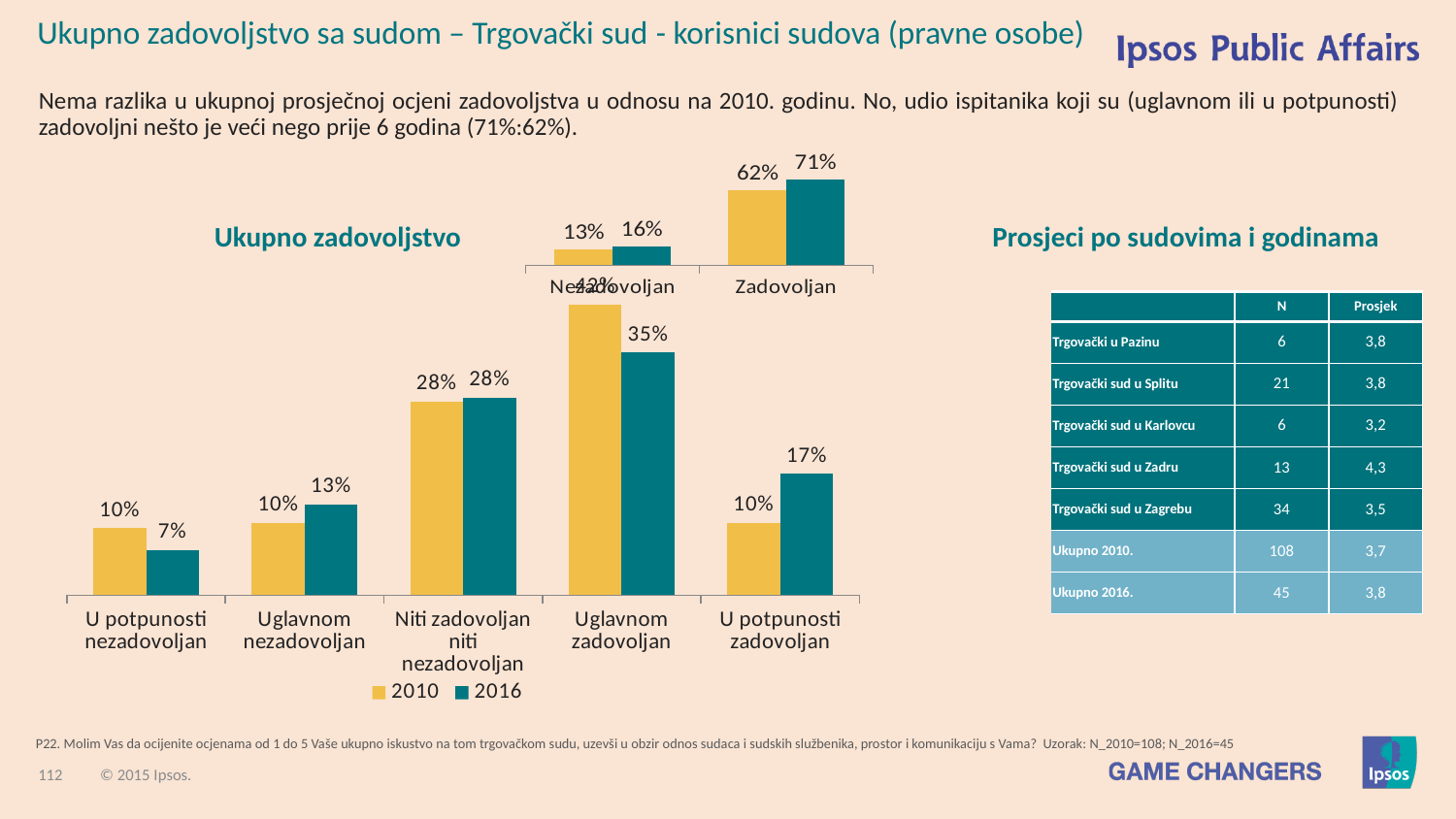
In the 'Ukupno zadovoljstvo' chart, what is the difference between the 2016 and 2010 values for 'U potpunosti zadovoljan'? 7% In the 'Ukupno zadovoljstvo' chart, which category has the lowest 2016 value? U potpunosti nezadovoljan How many series does the legend of the 'Ukupno zadovoljstvo' chart list? 2 In the 'Ukupno zadovoljstvo' chart, what is the 2016 value for 'U potpunosti nezadovoljan'? 7% In the small inset chart at the top, what is the difference between the 2016 and 2010 values for 'Zadovoljan'? 9% In the 'Ukupno zadovoljstvo' chart, is the 2016 value for 'Uglavnom nezadovoljan' larger or smaller than the 2010 value? larger In the small inset chart at the top, what is the 2016 value for 'Zadovoljan'? 71% How many categories are shown on the x axis of the 'Ukupno zadovoljstvo' chart? 5 What type of chart is the 'Ukupno zadovoljstvo' chart? bar chart In the 'Ukupno zadovoljstvo' chart, what is the 2016 value for 'U potpunosti zadovoljan'? 17% In the 'Ukupno zadovoljstvo' chart, what is the 2010 value for 'Niti zadovoljan niti nezadovoljan'? 28% In the small inset chart at the top, what is the 2010 value for 'Nezadovoljan'? 13%